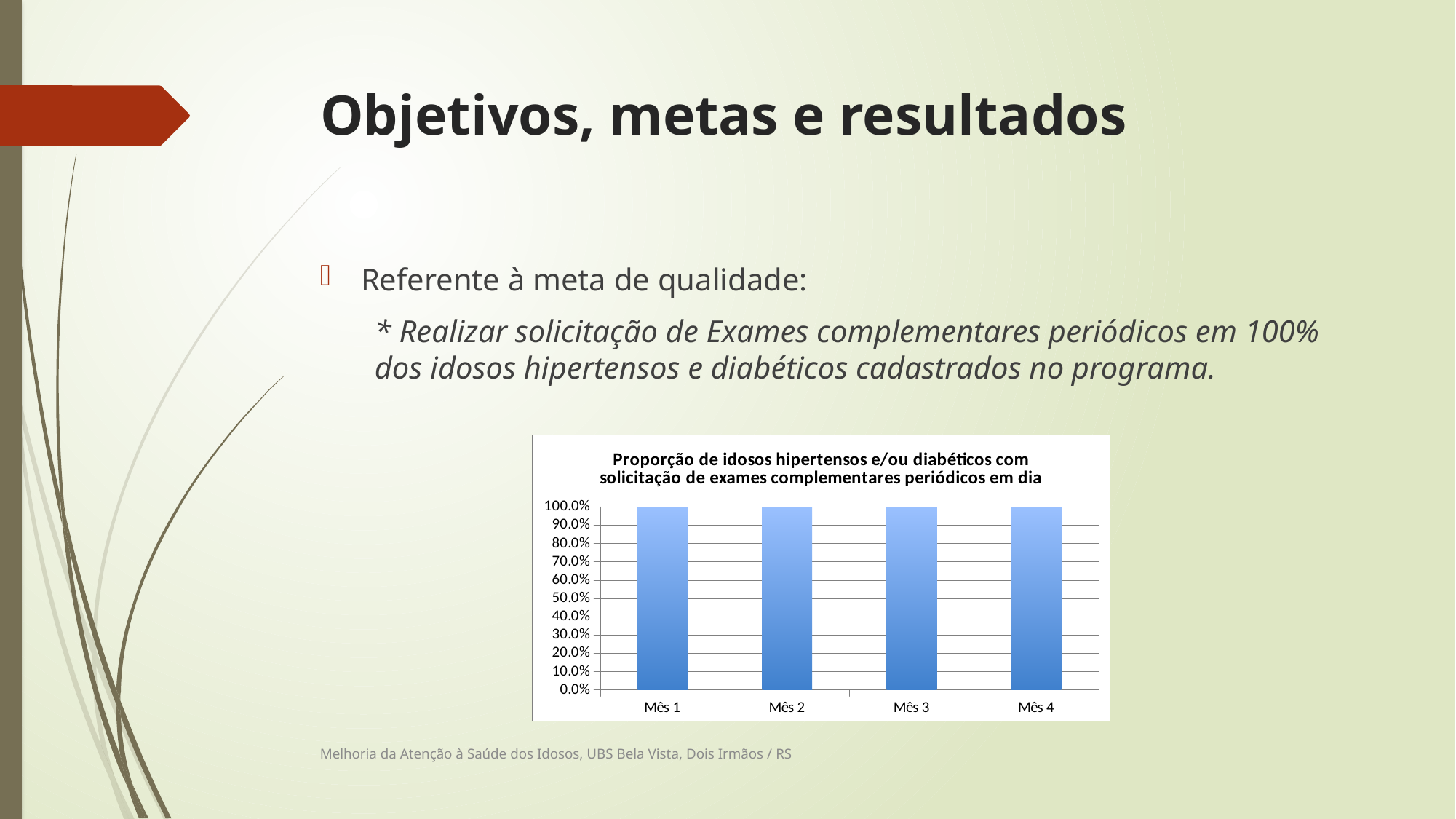
What is the title of the chart? Proporção de idosos hipertensos e/ou diabéticos com solicitação de exames complementares periódicos em dia Is the value for Mês 4 greater or less than 90.0%? greater How many categories (months) are shown on the x axis of the chart? 4 What is the label of the first category on the x axis of the chart? Mês 1 Is the value for Mês 2 greater or less than 50.0%? greater What kind of chart is shown on the slide? bar chart